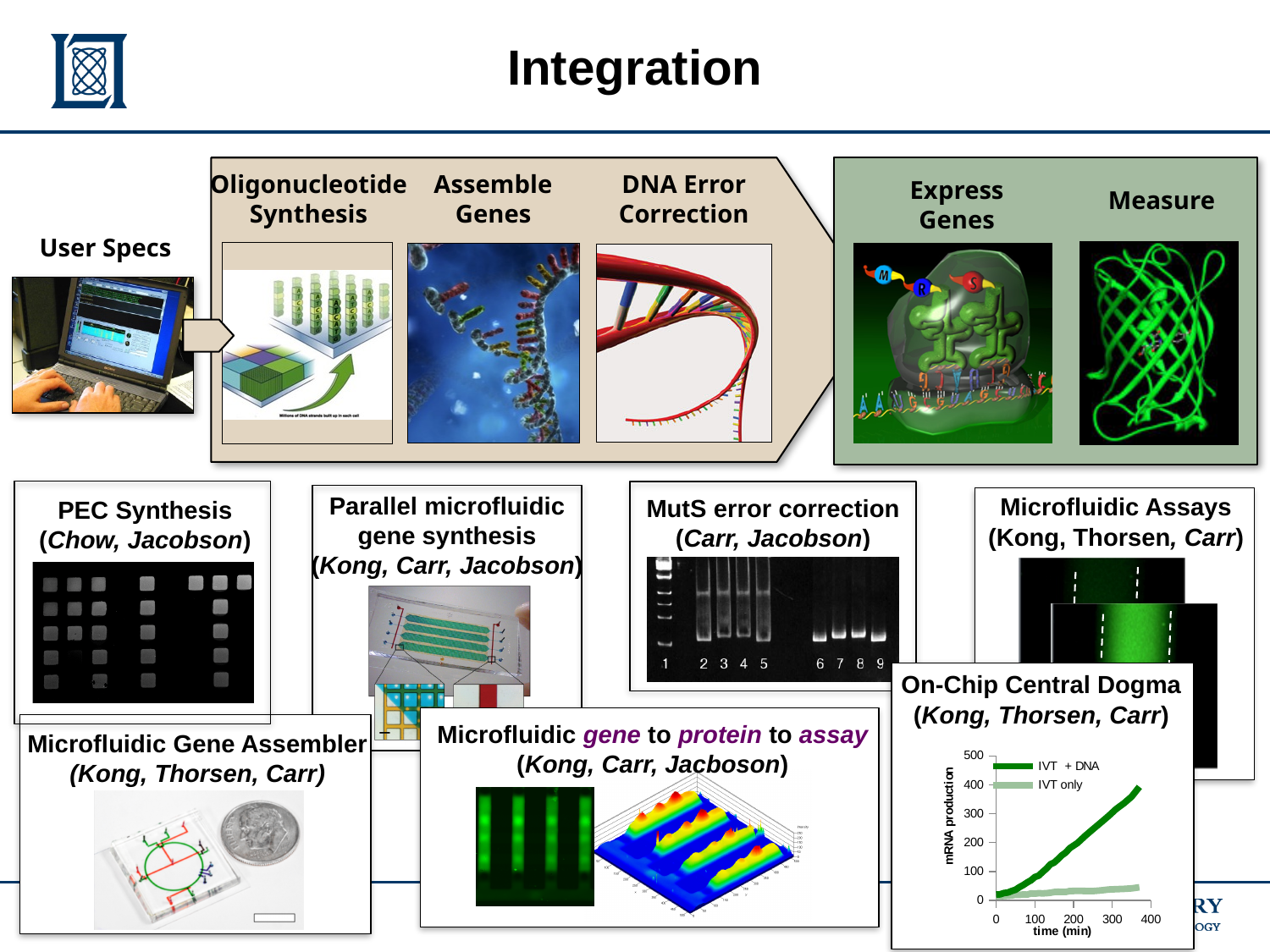
In the 'On-Chip Central Dogma' chart, which series is higher at 300 min, 'IVT + DNA' or 'IVT only'? IVT + DNA How many series does the legend of the 'On-Chip Central Dogma' chart list? 2 In the 'On-Chip Central Dogma' chart, is the 'IVT + DNA' value at 100 min greater or less than 200? less What kind of chart is shown in the 'On-Chip Central Dogma' panel? line chart In the 'On-Chip Central Dogma' chart, which series stays lowest across the whole time range? IVT only In the 'On-Chip Central Dogma' chart, what is the highest tick value shown on the y axis? 500 In the 'On-Chip Central Dogma' chart, does the 'IVT + DNA' series rise or fall as time increases? rise In the 'On-Chip Central Dogma' chart, is the 'IVT only' value at 350 min greater or less than 100? less In the 'On-Chip Central Dogma' chart, is the 'IVT + DNA' value at 350 min greater or less than 300? greater What is the label of the x axis in the 'On-Chip Central Dogma' chart? time (min) In the 'On-Chip Central Dogma' chart, what are the two series named in the legend? IVT + DNA and IVT only